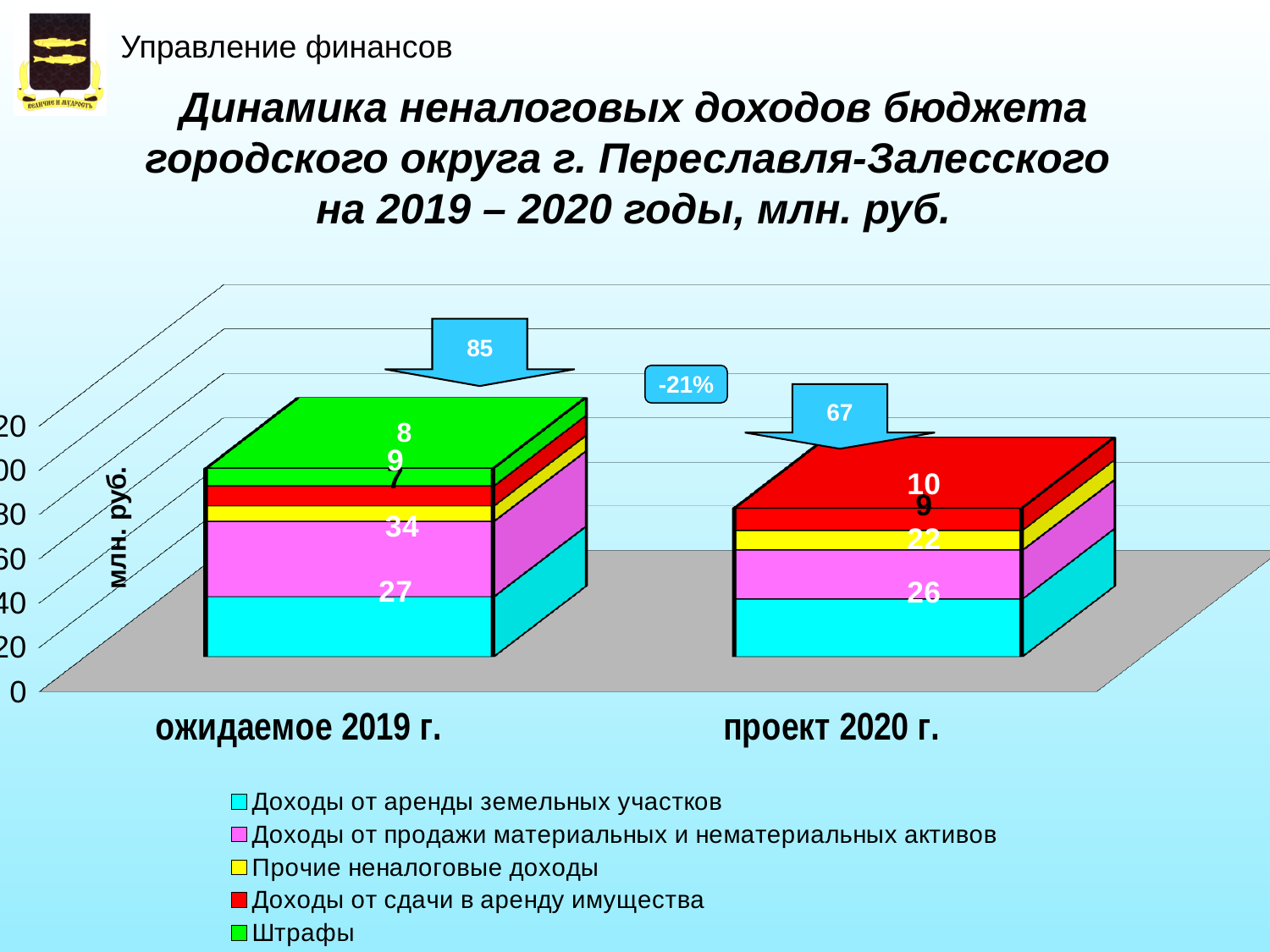
What is the value of 'Доходы от сдачи в аренду имущества' for 'проект 2020 г.'? 10 What type of chart is shown on the slide? stacked bar chart What is the difference between 'Доходы от продажи материальных и нематериальных активов' in 'ожидаемое 2019 г.' and 'проект 2020 г.'? 12 What is the total shown for the 'проект 2020 г.' bar? 67 What is the value of 'Доходы от продажи материальных и нематериальных активов' for 'проект 2020 г.'? 22 What is the value of 'Доходы от аренды земельных участков' for 'ожидаемое 2019 г.'? 27 Which is larger: 'Доходы от сдачи в аренду имущества' in 'ожидаемое 2019 г.' or in 'проект 2020 г.'? проект 2020 г. What percentage change is shown between the 2019 and 2020 bars? -21% How many series does the legend list? 5 What is the value of 'Штрафы' for 'ожидаемое 2019 г.'? 8 What is the total shown for the 'ожидаемое 2019 г.' bar? 85 How many categories are shown on the x axis? 2